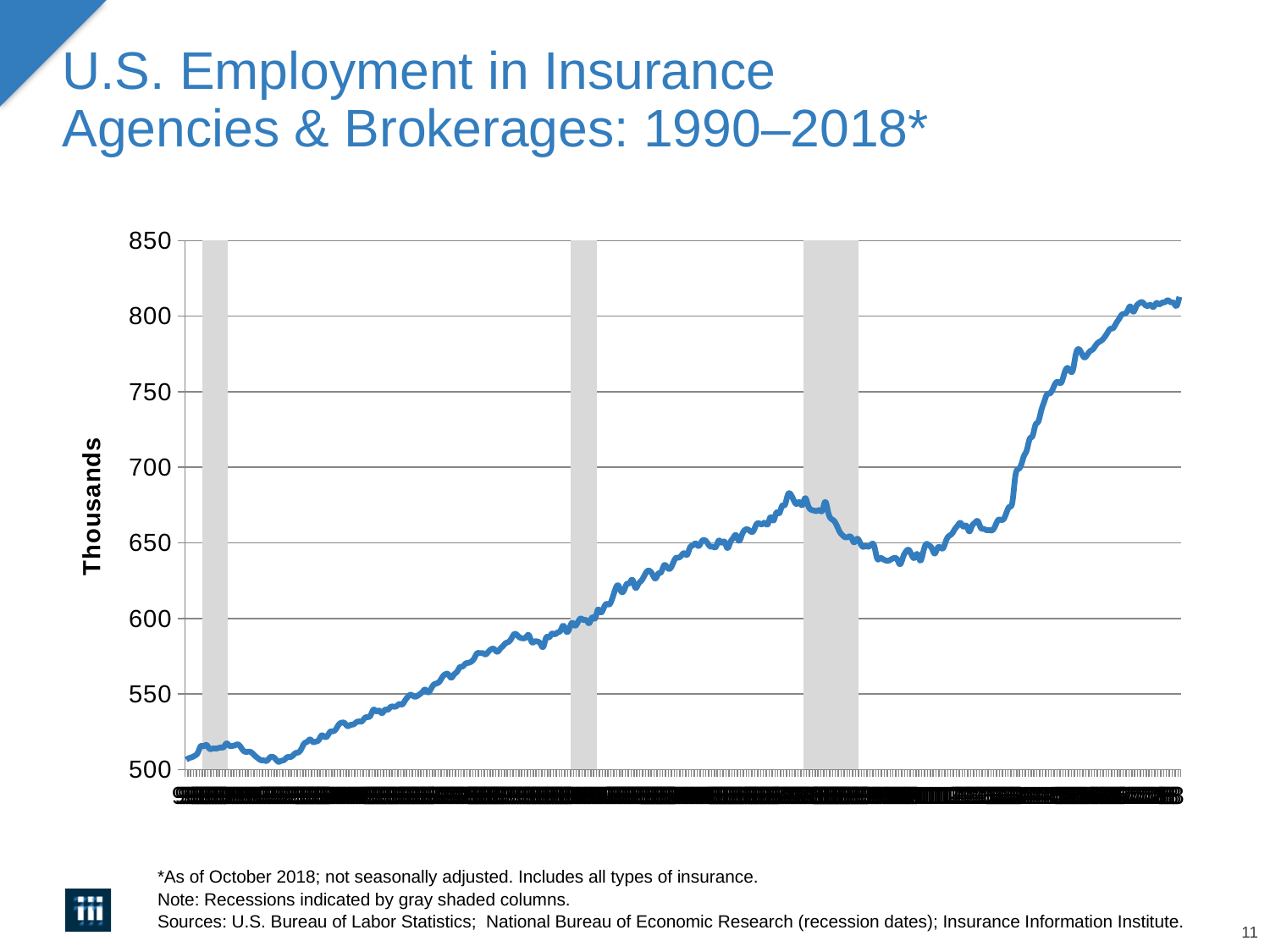
Which is larger, the value at the start of the series or the value at the end of the series? the end of the series How many gray shaded recession columns are shown on the chart? 3 Is the low point reached after the third gray shaded recession column greater or less than 600? greater What kind of chart is shown on the slide? line chart Is the value at the end of the series (2018) greater or less than 750? greater Where along the series does the lowest value occur, near the start or near the end? near the start Where along the series does the highest value occur, near the start or near the end? near the end Is the value at the start of the series (1990) greater or less than 550? less What is the label on the vertical axis? Thousands Overall, do the values rise or fall from 1990 to 2018? rise